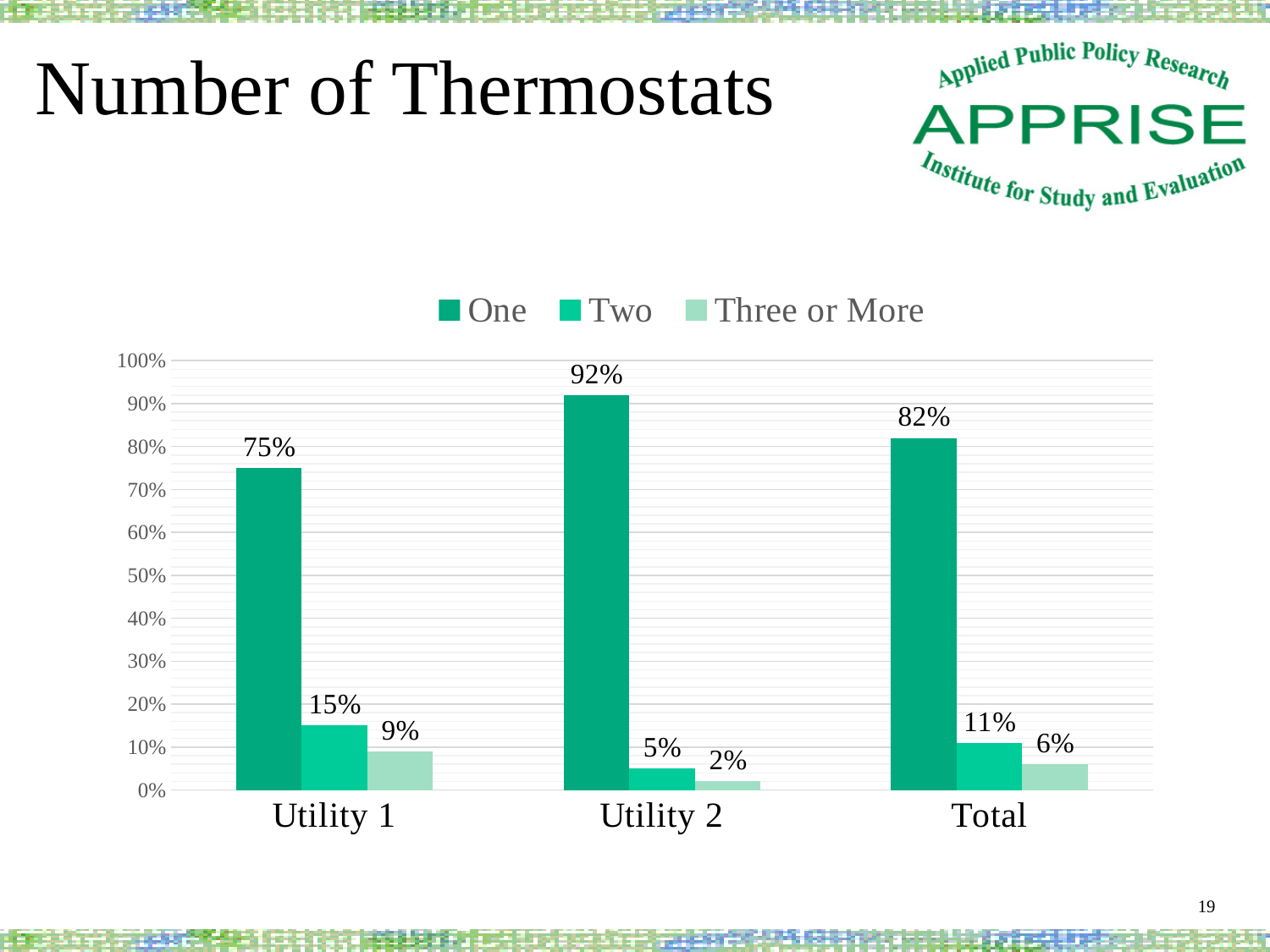
What is the value for 'Three or More' thermostats in the Total category? 6% What is the difference between the 'One' values for Utility 2 and Utility 1? 17% How many series does the legend list? 3 Which is larger: the 'Two' value for Utility 1 or the 'Two' value for Total? Utility 1 Which category has the highest value for 'One' thermostat? Utility 2 Which category has the lowest value for 'Three or More' thermostats? Utility 2 What is the title of the slide containing the chart? Number of Thermostats Is the 'One' value for Total greater or less than 80%? greater How many categories are shown on the x axis? 3 What percentage of Utility 1 households have one thermostat? 75% What is the value for 'Two' thermostats for Utility 2? 5% What kind of chart is shown on the slide? bar chart